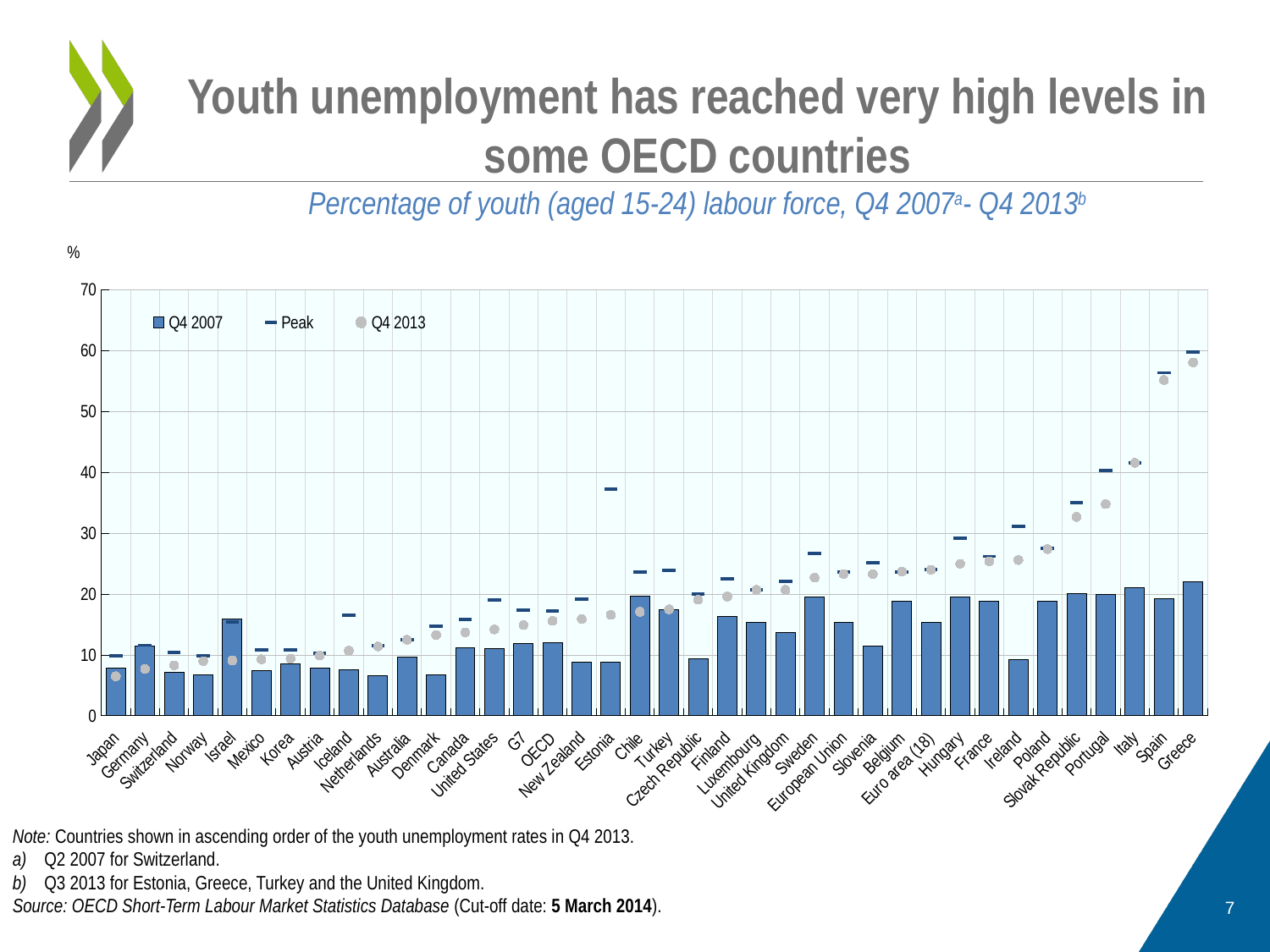
Is the Q4 2013 value for Portugal greater or less than 30? greater Is the Peak value for Estonia greater or less than 30? greater Is the Q4 2013 value for Japan greater or less than 10? less Do the Q4 2013 values generally rise or fall moving from left to right along the x axis? Rise Which has the larger Q4 2013 value, Spain or Germany? Spain Which country has the highest Q4 2013 youth unemployment rate? Greece How many series does the legend list? 3 Which country has the lowest Q4 2013 youth unemployment rate? Japan What are the three series named in the legend? Q4 2007, Peak, Q4 2013 What kind of chart is used to show the Q4 2007 series? Bar chart How many countries or regions are shown along the x axis? 38